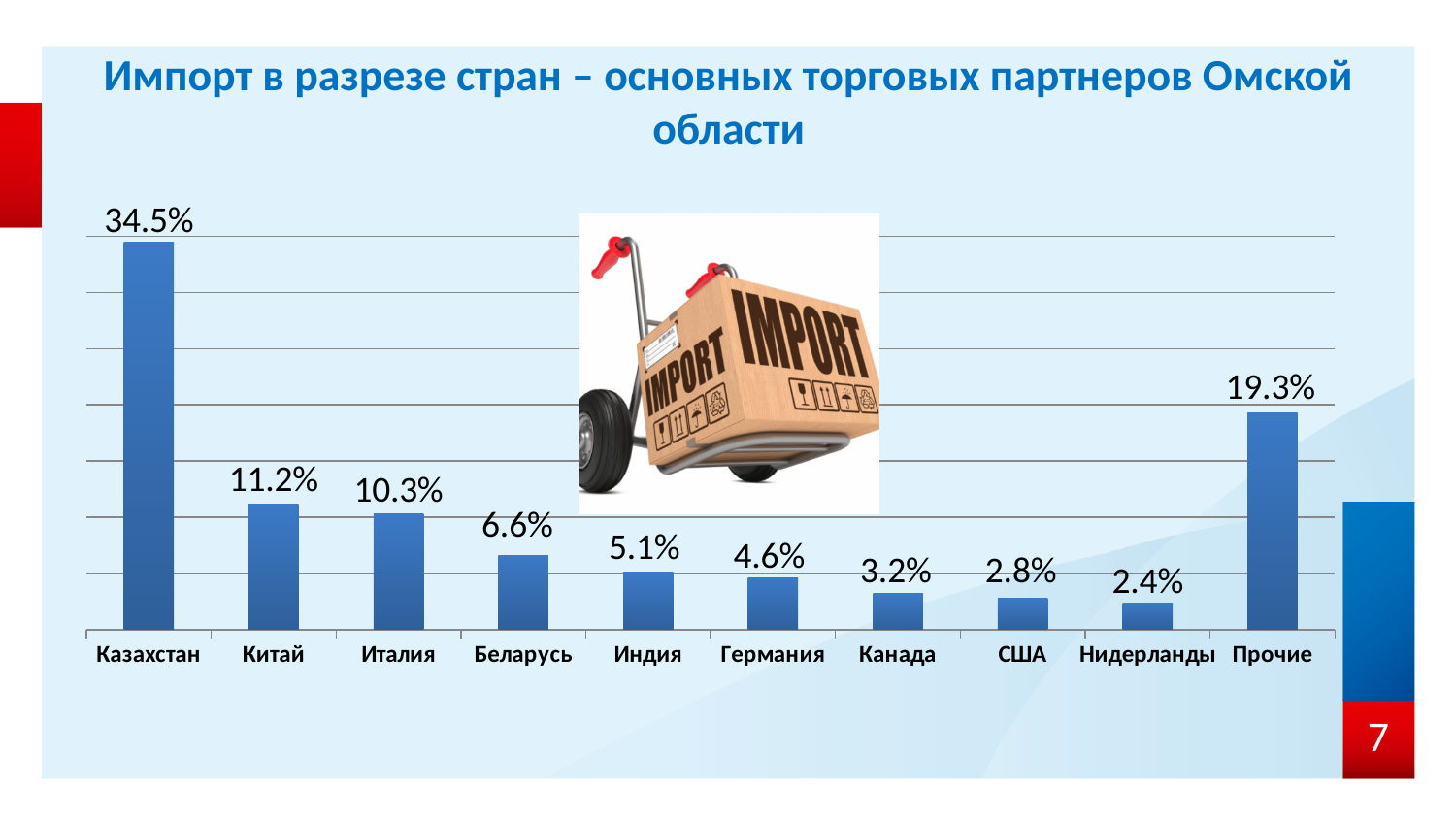
What is the difference between the values for Казахстан and Прочие? 15.2% What is the difference between the values for Китай and Италия? 0.9% Which category has the lowest value? Нидерланды What is the value for Прочие? 19.3% What is the value for Германия? 4.6% How many categories are shown on the x axis? 10 Which country has the highest import share? Казахстан What is the value for Казахстан? 34.5% Which is larger, the value for Беларусь or the value for Индия? Беларусь What is the value for Нидерланды? 2.4% What is the title of the chart? Импорт в разрезе стран – основных торговых партнеров Омской области What kind of chart is shown on the slide? Bar chart